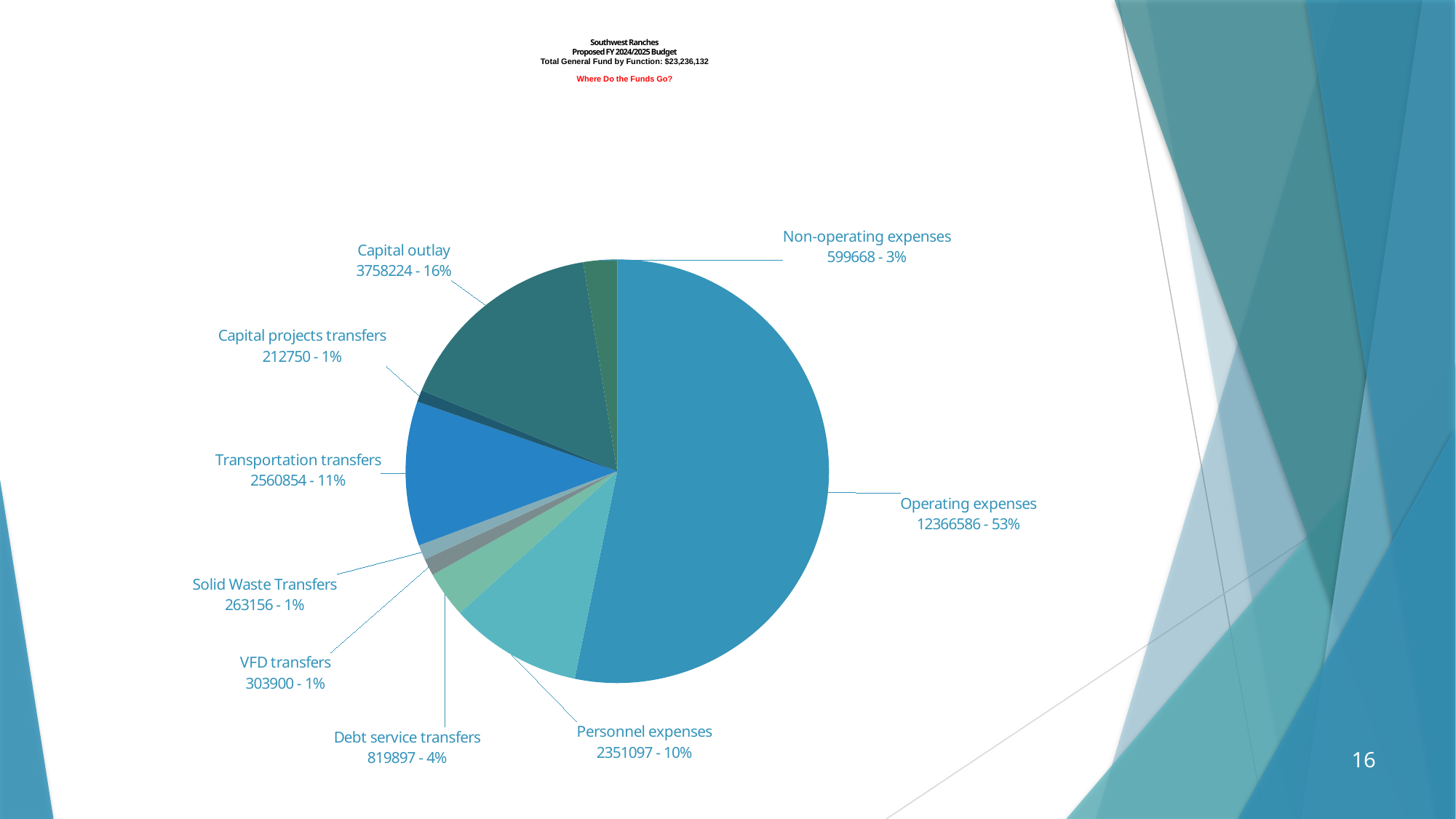
What is the difference between Capital outlay and Transportation transfers? 1197370 What share of the pie is Personnel expenses? 10% Which is larger, Non-operating expenses or Debt service transfers? Debt service transfers What value is shown for Operating expenses? 12366586 What kind of chart is shown on the slide? Pie chart What share of the pie is Debt service transfers? 4% What is the difference between Debt service transfers and VFD transfers? 515997 Which category has the largest slice of the pie? Operating expenses What value is shown for Capital outlay? 3758224 Which category has the smallest value? Capital projects transfers How many categories are shown in the pie chart? 9 What value is shown for Transportation transfers? 2560854